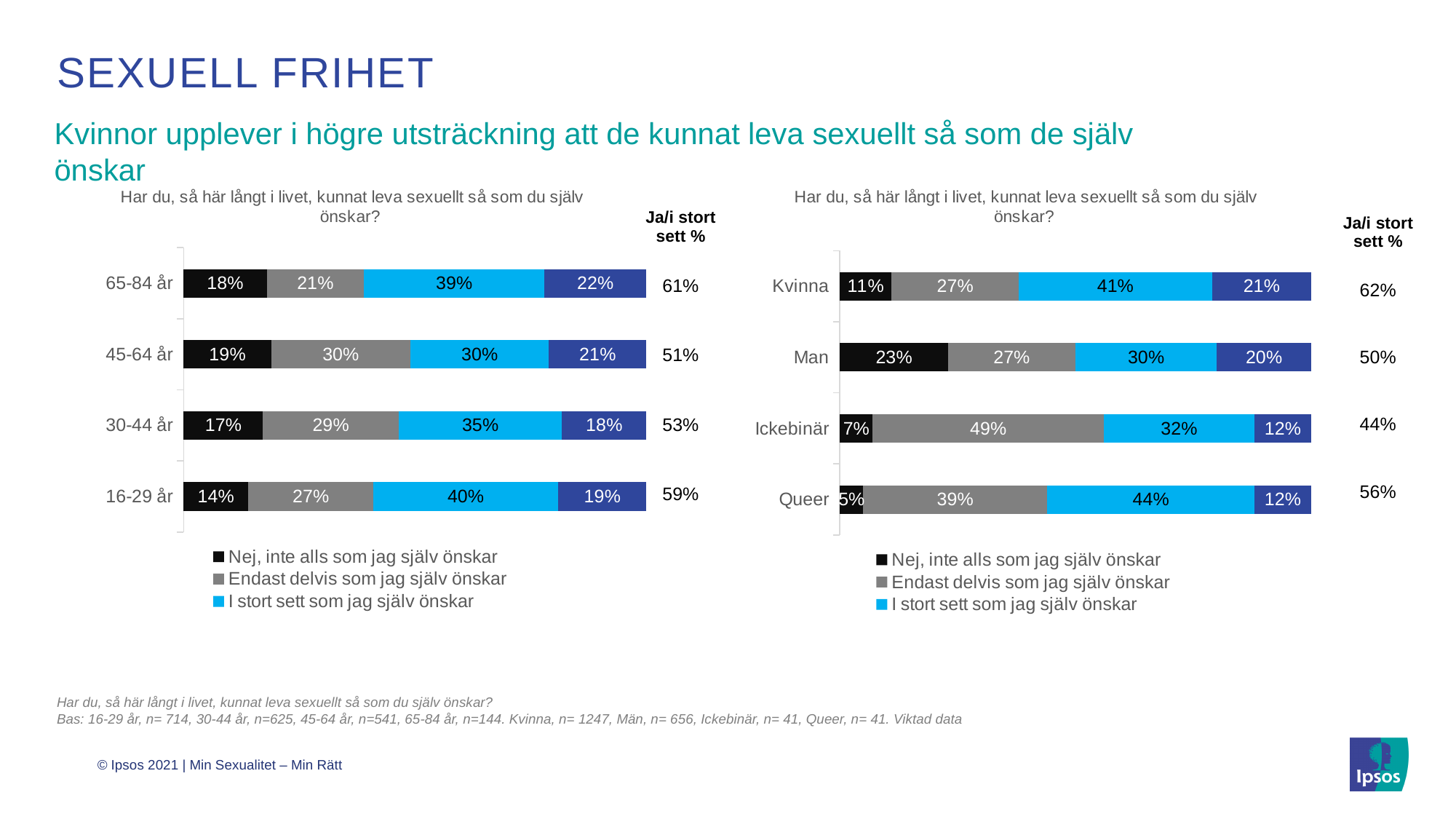
In the right chart (gender), what percentage of Ickebinär answered 'Endast delvis som jag själv önskar'? 49% In the left chart (age groups), what is the difference between the 'Endast delvis som jag själv önskar' values for 45-64 år and 65-84 år? 9 percentage points In the left chart (age groups), what percentage of 45-64 år answered 'Nej, inte alls som jag själv önskar'? 19% How many categories are shown in the right chart (gender)? 4 In the left chart (age groups), what percentage of 65-84 år answered 'I stort sett som jag själv önskar'? 39% In the right chart (gender), which is larger: the 'I stort sett som jag själv önskar' value for Queer or for Man? Queer In the left chart (age groups), which age group has the lowest 'Ja/i stort sett %' value? 45-64 år In the right chart (gender), which group has the highest 'Nej, inte alls som jag själv önskar' value? Man In the left chart (age groups), which age group has the highest 'Ja/i stort sett %' value? 65-84 år What type of chart is the left chart (age groups)? Stacked bar chart How many series does the legend of the left chart (age groups) list? 3 In the right chart (gender), what is the 'Ja/i stort sett %' value for Kvinna? 62%